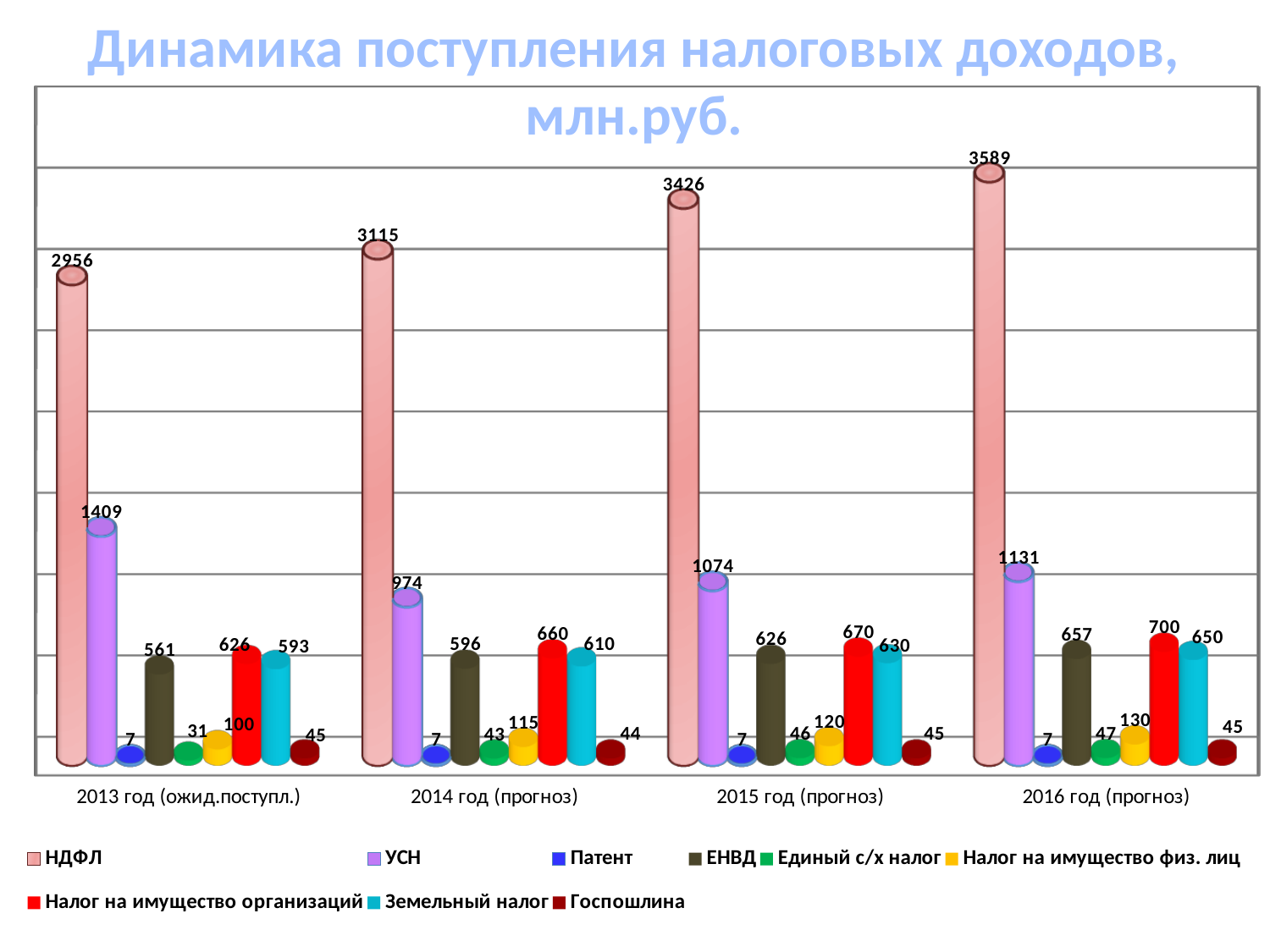
What is the difference between the НДФЛ values for 2016 год (прогноз) and 2013 год (ожид.поступл.)? 633 In which year is the НДФЛ value highest? 2016 год (прогноз) In which year is the УСН value lowest? 2014 год (прогноз) Does the НДФЛ value rise or fall from 2013 to 2016? rise What is the value for НДФЛ in 2016 год (прогноз)? 3589 What is the value for Налог на имущество физ. лиц in 2014 год (прогноз)? 115 How many year categories are shown on the x axis? 4 What kind of chart is shown on the slide? bar chart Which is larger in 2015 год (прогноз): ЕНВД or Земельный налог? Земельный налог How many series does the legend list? 9 What is the value for Земельный налог in 2015 год (прогноз)? 630 What is the value for УСН in 2013 год (ожид.поступл.)? 1409